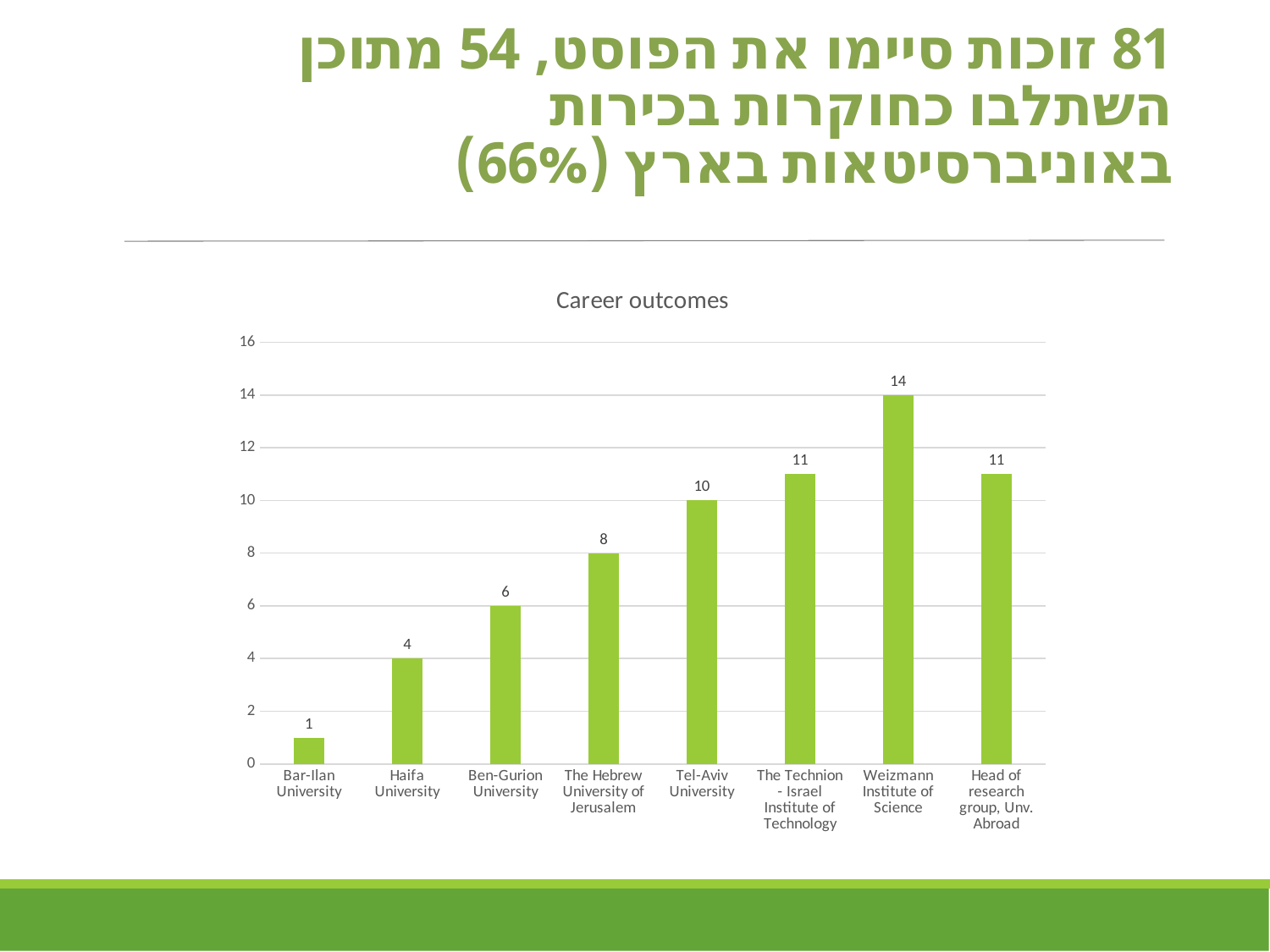
What is the value for Tel-Aviv University? 10 What is the difference between the values for Weizmann Institute of Science and Haifa University? 10 What is the value for Weizmann Institute of Science? 14 Which category has the lowest value? Bar-Ilan University What is the value for Bar-Ilan University? 1 Which is larger, the value for Ben-Gurion University or the value for Tel-Aviv University? Tel-Aviv University How many categories are shown on the x axis? 8 Which category has the highest value? Weizmann Institute of Science What is the value for The Hebrew University of Jerusalem? 8 Is the value for The Technion - Israel Institute of Technology greater or less than 10? greater What is the title of the chart? Career outcomes What kind of chart is this? bar chart